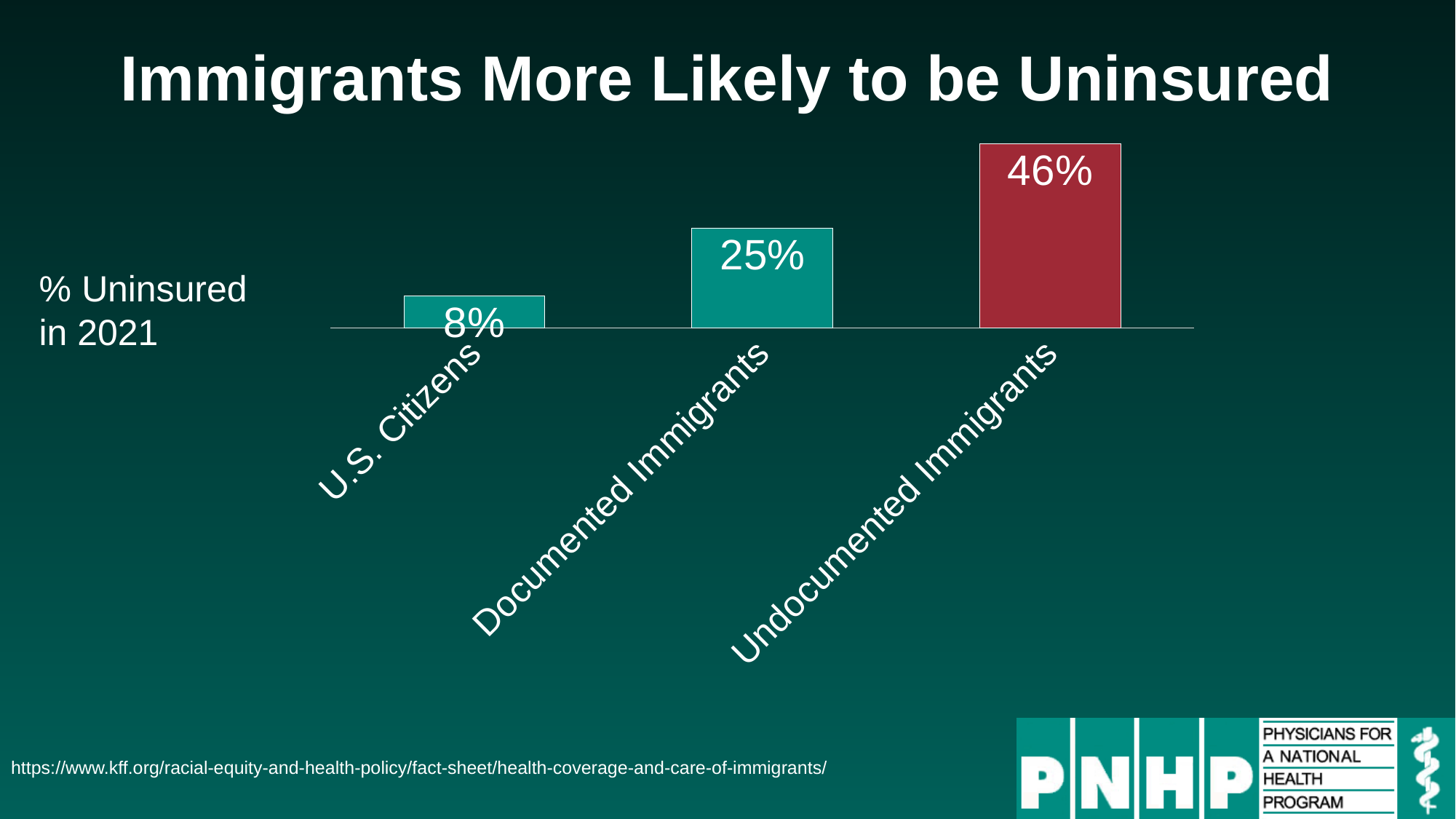
What is the title of the slide containing the chart? Immigrants More Likely to be Uninsured What is the percentage uninsured in 2021 for Undocumented Immigrants? 46% What is the difference in percentage uninsured between Undocumented Immigrants and U.S. Citizens? 38% What is the percentage uninsured in 2021 for U.S. Citizens? 8% What is the percentage uninsured in 2021 for Documented Immigrants? 25% What is the difference in percentage uninsured between Undocumented Immigrants and Documented Immigrants? 21% Which group has the highest percentage uninsured? Undocumented Immigrants Which group has a higher percentage uninsured, Documented Immigrants or U.S. Citizens? Documented Immigrants Do the values rise or fall moving from left to right across the chart? Rise Which group has the lowest percentage uninsured? U.S. Citizens What kind of chart is shown on the slide? Bar chart How many groups are shown in the chart? 3